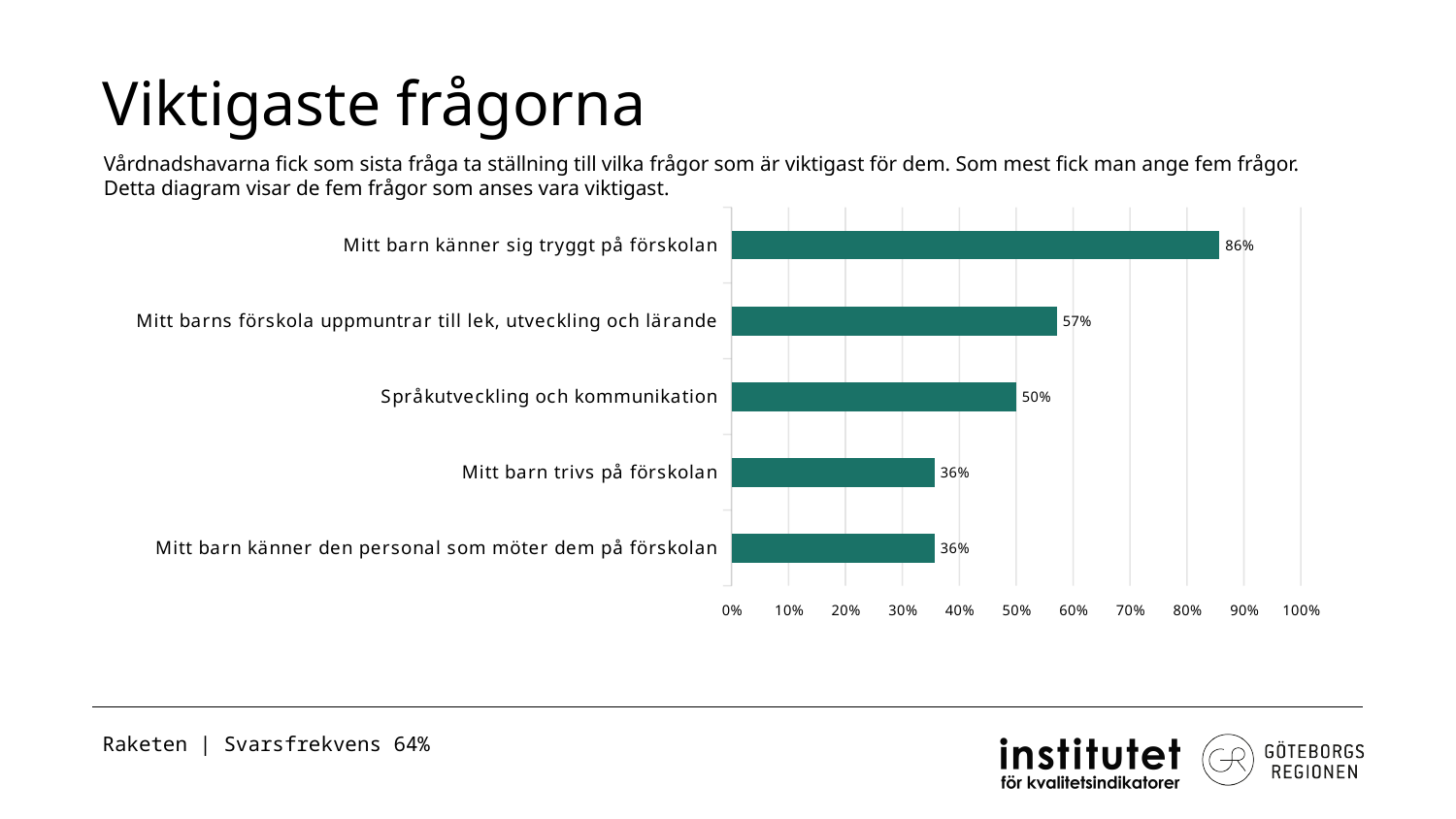
What is the value for "Mitt barn känner sig tryggt på förskolan"? 86% What is the value for "Språkutveckling och kommunikation"? 50% Is the value for "Mitt barn känner den personal som möter dem på förskolan" greater or less than 40%? less What is the difference between the values for "Språkutveckling och kommunikation" and "Mitt barn trivs på förskolan"? 14% How many categories are shown in the chart? 5 What is the title of the slide? Viktigaste frågorna Which is larger: the value for "Mitt barns förskola uppmuntrar till lek, utveckling och lärande" or the value for "Språkutveckling och kommunikation"? Mitt barns förskola uppmuntrar till lek, utveckling och lärande What is the difference between the values for "Mitt barn känner sig tryggt på förskolan" and "Mitt barns förskola uppmuntrar till lek, utveckling och lärande"? 29% What kind of chart is shown on the slide? Bar chart What is the value for "Mitt barns förskola uppmuntrar till lek, utveckling och lärande"? 57% Which category has the highest value? Mitt barn känner sig tryggt på förskolan What is the value for "Mitt barn trivs på förskolan"? 36%